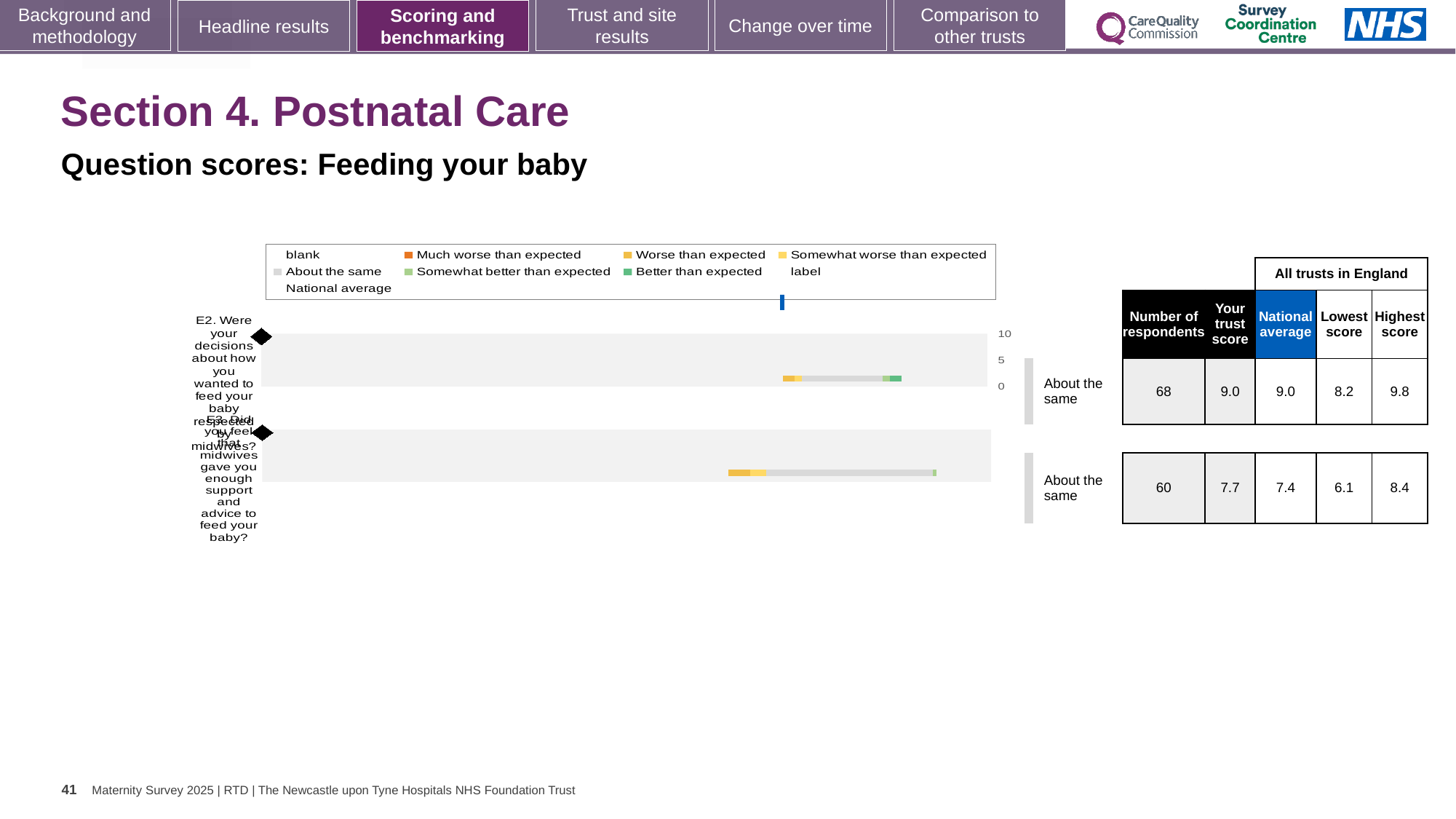
How many respondents answered question E2 about whether decisions on feeding the baby were respected by midwives? 68 What kind of chart is used to show the question scores? Bar chart What is the highest score among all trusts in England for question E2? 9.8 What is the national average score for question E3 (midwives gave enough support and advice to feed your baby)? 7.4 What is the trust's score for question E2 (decisions about how you wanted to feed your baby respected by midwives)? 9.0 What is the difference between the highest and lowest scores across all trusts in England for question E3? 2.3 What is the lowest score among all trusts in England for question E3? 6.1 By how much does the trust's score for question E3 exceed the national average for that question? 0.3 What benchmark category is shown for question E2? About the same How many questions are plotted in the chart? 2 For question E3, which is larger: the trust's score or the national average? Your trust score Which question had more respondents, E2 or E3? E2